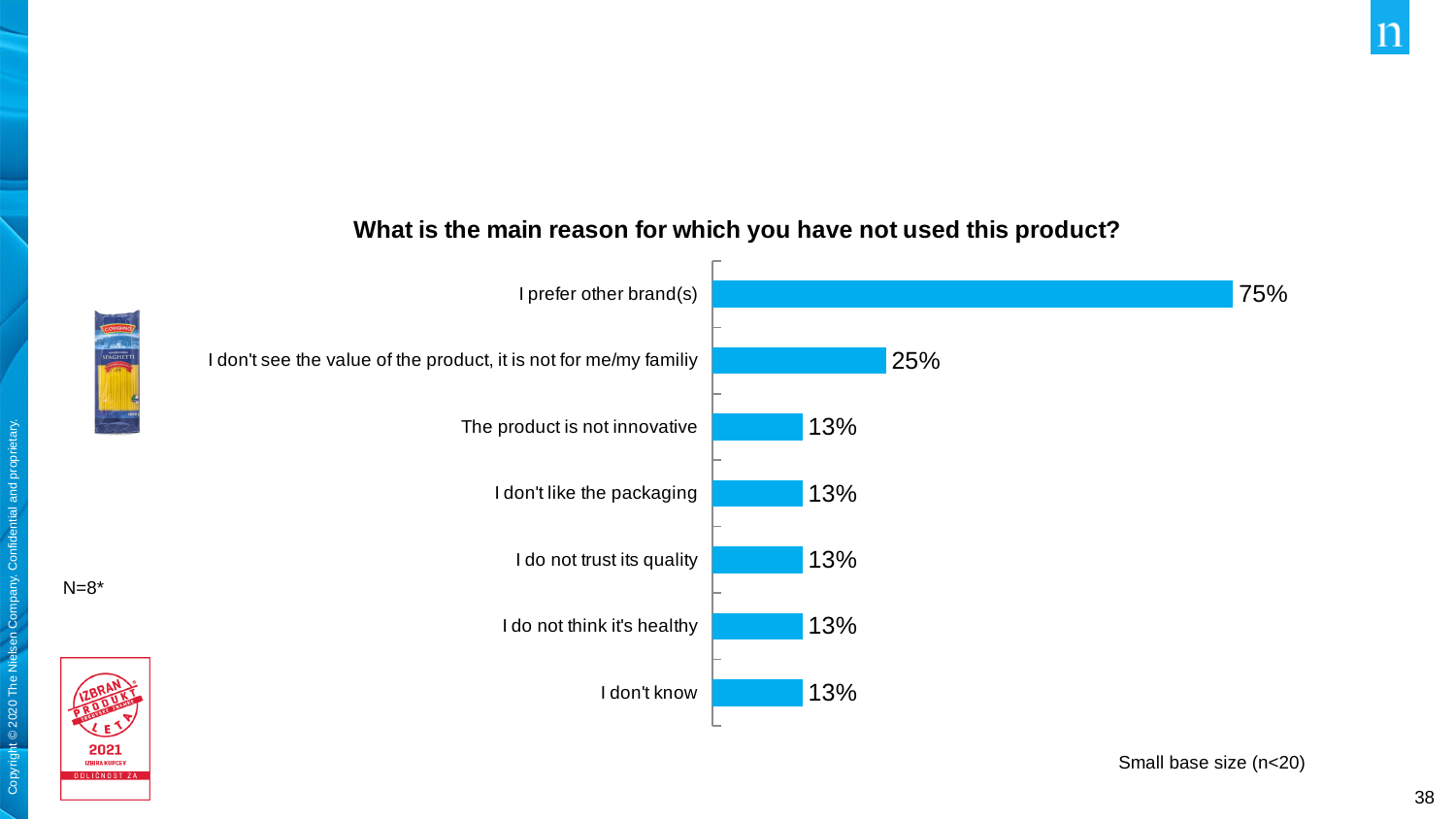
What kind of chart is shown on the slide? Bar chart What is the value for "I don't see the value of the product, it is not for me/my familiy"? 25% What percentage of respondents said "I prefer other brand(s)"? 75% How many reasons share the value 13%? 5 How many reasons are shown in the chart? 7 Which reason has the highest value? I prefer other brand(s) What is the title of the chart? What is the main reason for which you have not used this product? Which is larger: "I prefer other brand(s)" or "I do not trust its quality"? I prefer other brand(s) What is the difference between "I prefer other brand(s)" and "I don't see the value of the product, it is not for me/my familiy"? 50 percentage points What is the value for "I don't know"? 13% What is the difference between "I don't see the value of the product, it is not for me/my familiy" and "The product is not innovative"? 12 percentage points What is the sample size (N) noted on the slide? N=8*